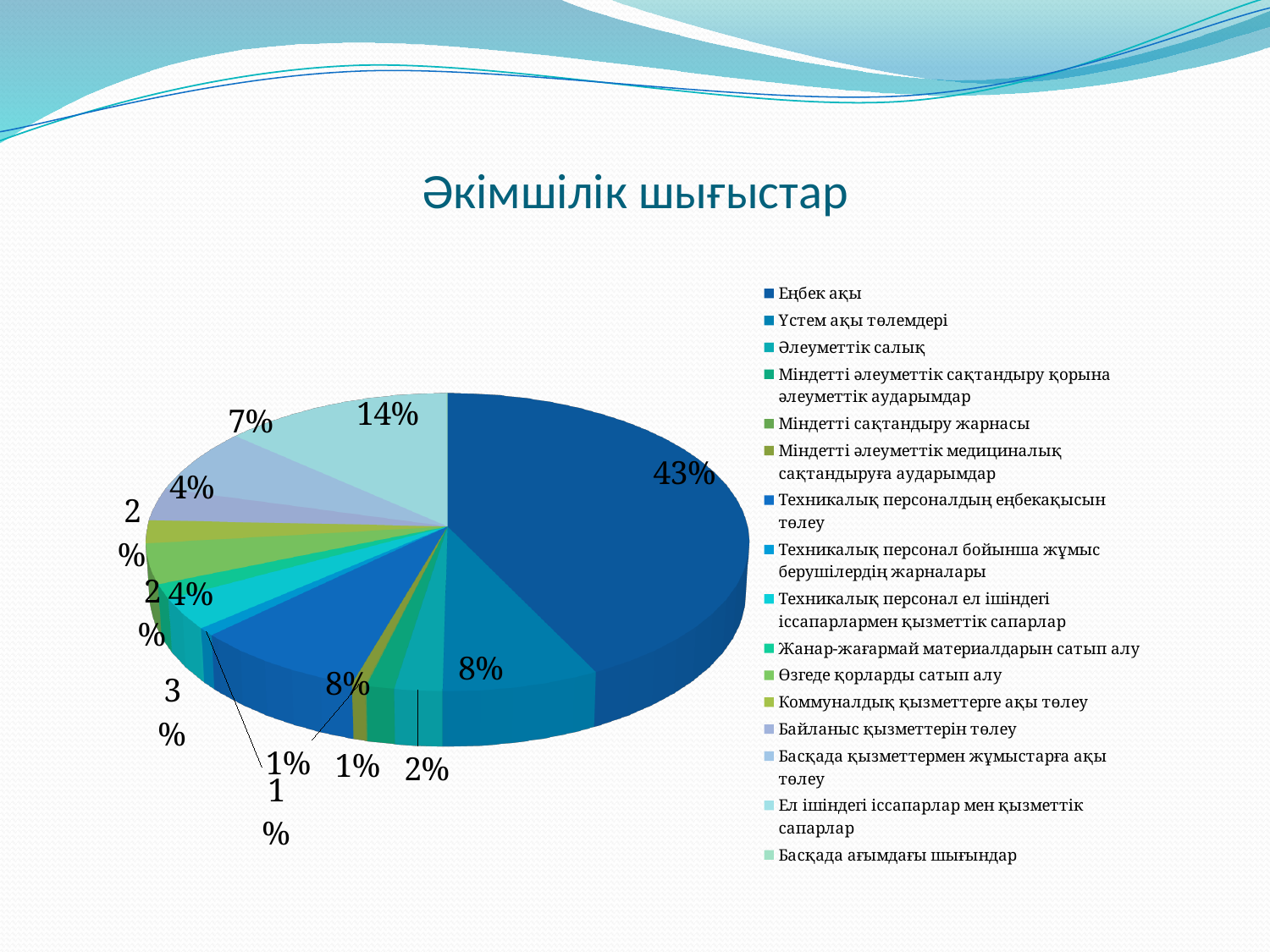
Is the largest slice of the pie greater or less than 40%? greater What is the first entry listed in the legend? Еңбек ақы How many entries does the legend list? 16 What is the value shown for Еңбек ақы? 43% What is the smallest percentage labelled on the pie? 1% Which is larger, the slice labelled 7% or the slice labelled 14%? 14% What is the title of the chart? Әкімшілік шығыстар Which category has the largest slice of the pie? Еңбек ақы What is the second-largest percentage labelled on the pie? 14% What is the difference between the largest slice (43%) and the 14% slice? 29% What kind of chart is shown on the slide? pie chart What share of the pie does the largest slice take? 43%